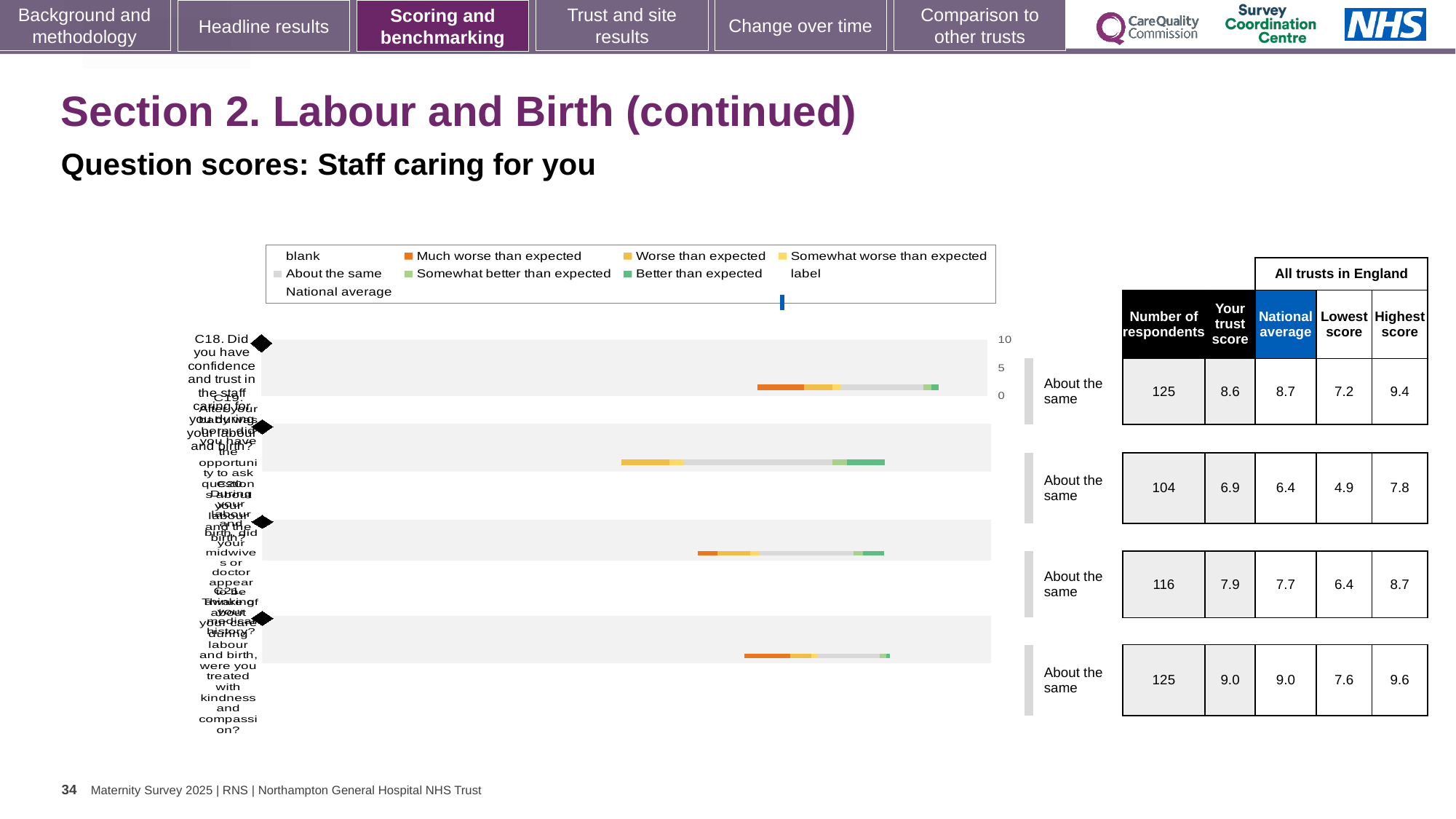
How many question bars are plotted in the chart? 4 What is the national average score for question C18? 8.7 What is the trust score for question C18 (confidence and trust in the staff caring for you during labour and birth)? 8.6 How many respondents answered question C18? 125 Which colour in the chart legend represents 'Much worse than expected'? orange Is the trust score for the fourth question row (C21) larger or smaller than the trust score for the third question row (C20)? larger What is the lowest score among all trusts in England for the second question row (C19)? 4.9 What is the difference between the trust score and the national average for the second question row (C19)? 0.5 What is the highest score among all trusts in England for question C18? 9.4 Which question row has the lowest trust score? C19 (6.9) Which colour in the chart legend represents 'Better than expected'? green What kind of chart is shown on the slide? bar chart